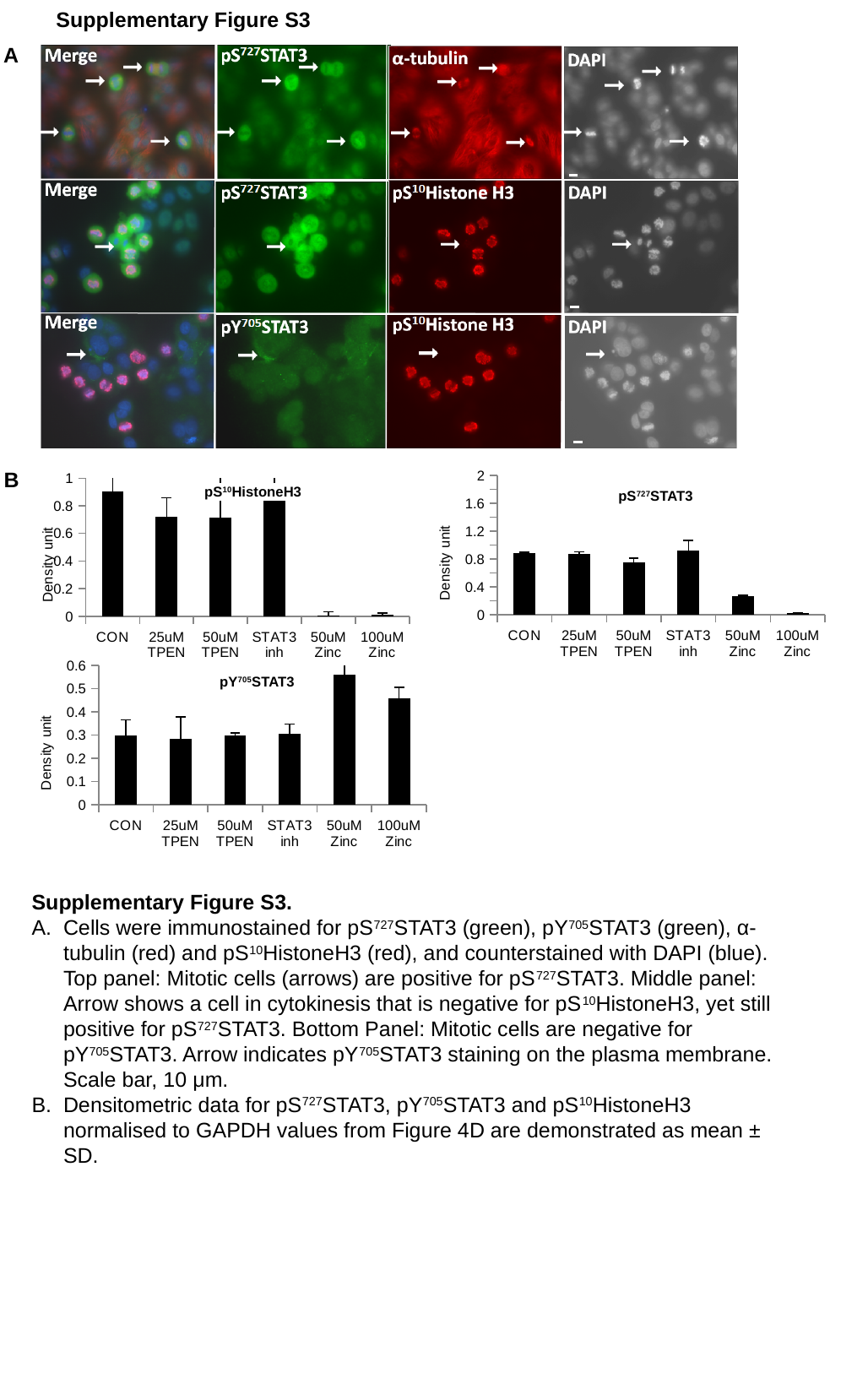
What is the y-axis label on the pS727STAT3 chart? Density unit How many categories are shown on the x axis of the pS10HistoneH3 chart? 6 In the pY705STAT3 chart, which category has the highest value? 50uM Zinc In the pS10HistoneH3 chart, is the value for CON greater or less than 0.8? greater In the pS727STAT3 chart, which is larger, the value for 50uM Zinc or 100uM Zinc? 50uM Zinc In the pS10HistoneH3 chart, which category has the highest value? CON In the pY705STAT3 chart, is the value for 50uM Zinc greater or less than 0.5? greater In the pY705STAT3 chart, is the value for CON greater or less than 0.4? less What kind of chart is the pY705STAT3 chart? bar chart In the pS727STAT3 chart, which category has the lowest value? 100uM Zinc